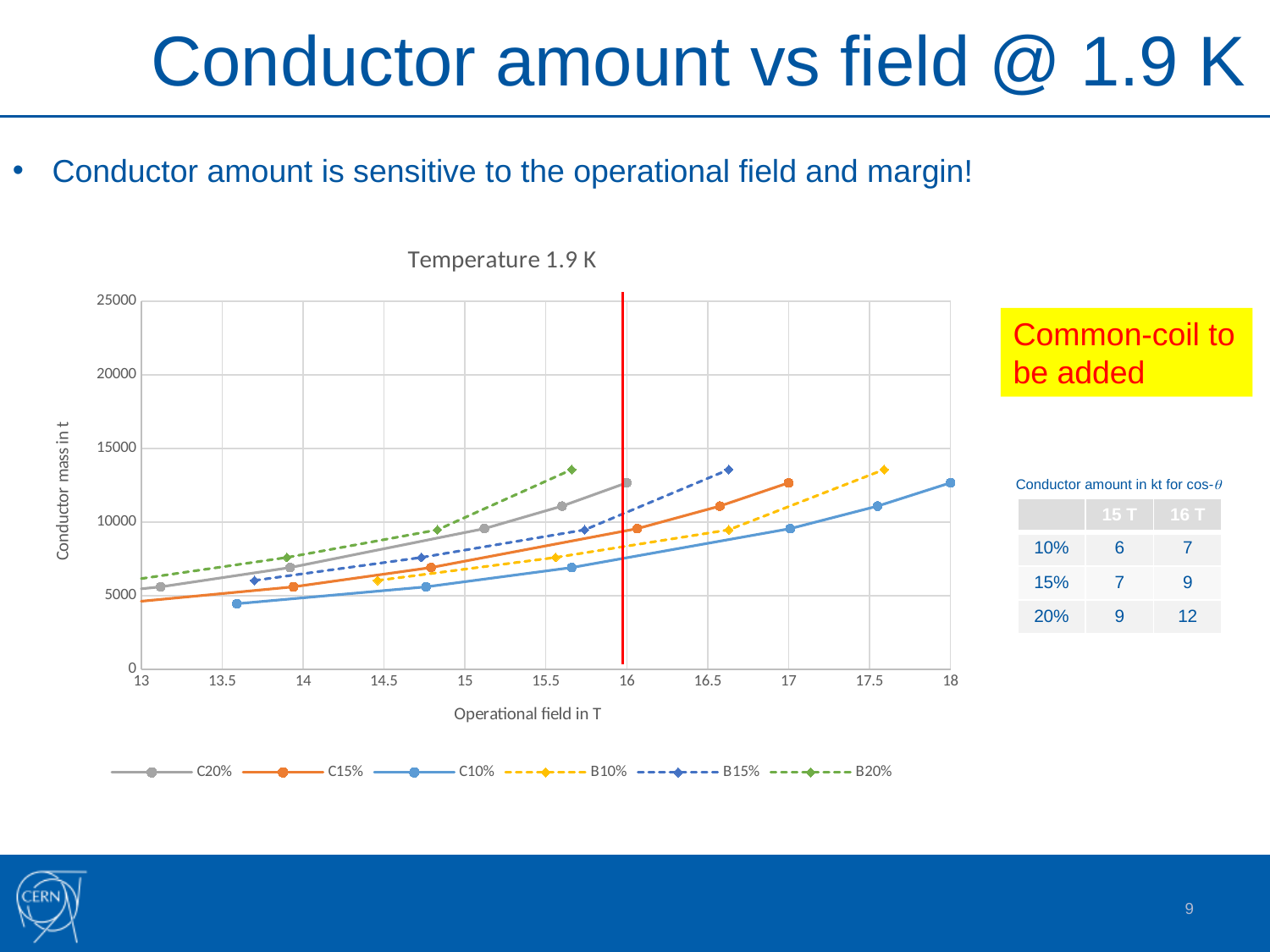
Do the conductor mass values for the B20% series rise or fall as the operational field increases? rise What kind of chart is shown on the slide? line chart Is the conductor mass for the C10% series at 18 T greater or less than 10000? greater Is the conductor mass for the C20% series at 16 T greater or less than 10000? greater Do the conductor mass values for the C10% series rise or fall as the operational field increases? rise What is the title of the chart? Temperature 1.9 K How many series does the chart legend list? 6 At 16 T, which series has the larger conductor mass, C20% or B10%? C20% Is the conductor mass for the B10% series at its highest plotted field (about 17.6 T) greater or less than 10000? greater At 15 T, which series has the larger conductor mass, C20% or C10%? C20% What is the label of the vertical axis of the chart? Conductor mass in t